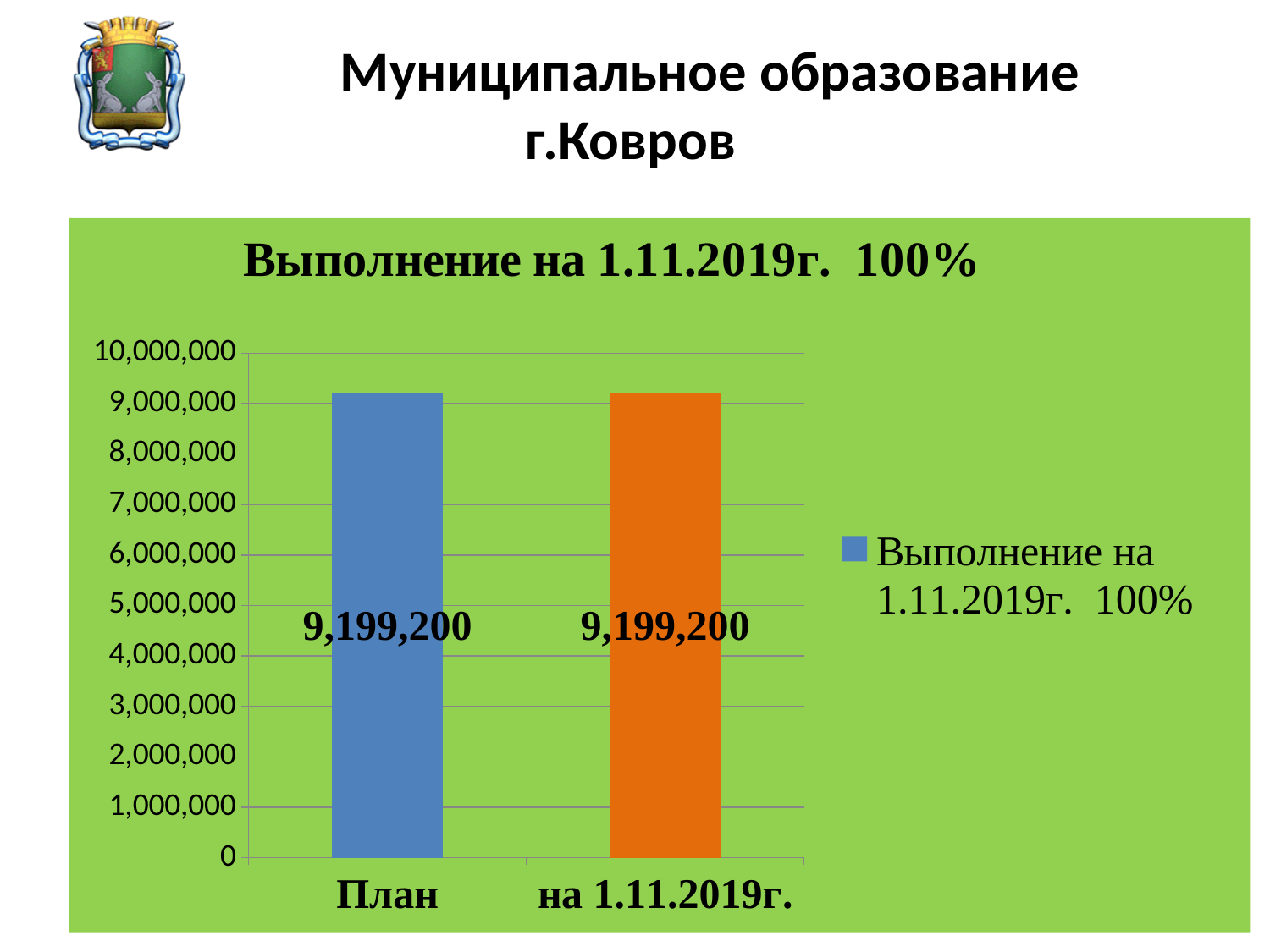
What is the highest value shown on the vertical axis? 10,000,000 How many bars are plotted in the chart? 2 How many series does the legend list? 1 What kind of chart is shown on the slide? Bar chart Is the value for на 1.11.2019г. greater or less than 10,000,000? less What colour is the bar for на 1.11.2019г.? Orange What is the title of the chart? Выполнение на 1.11.2019г. 100% What is the value of the bar labelled на 1.11.2019г.? 9,199,200 What is the difference between the План value and the на 1.11.2019г. value? 0 What is the value of the План bar? 9,199,200 Is the value for План greater or less than 9,000,000? greater